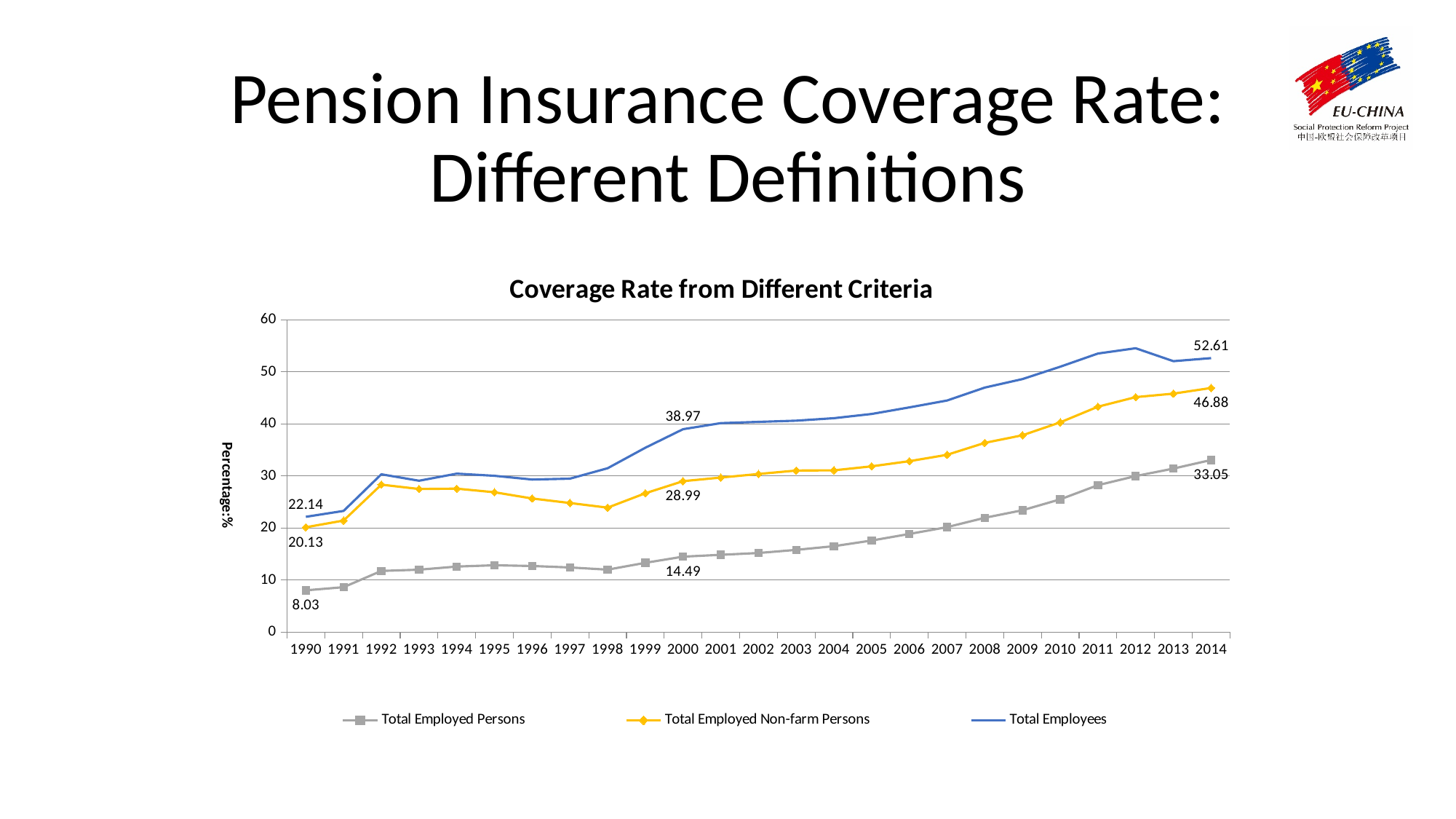
Which series has the highest value in 2014? Total Employees Is the value for Total Employed Persons in 2010 greater or less than 30? less What is the difference between Total Employees and Total Employed Persons in 2014? 19.56 What type of chart is shown on the slide? line chart What is the value for Total Employees in 2014? 52.61 What is the value for Total Employed Persons in 1990? 8.03 What is the value for Total Employed Non-farm Persons in 2000? 28.99 Does the Total Employed Persons series generally rise or fall from 1990 to 2014? rise What is the value for Total Employees in 2000? 38.97 How many series does the legend list? 3 What is the title of the chart? Coverage Rate from Different Criteria Which series has the lowest value in 1990? Total Employed Persons